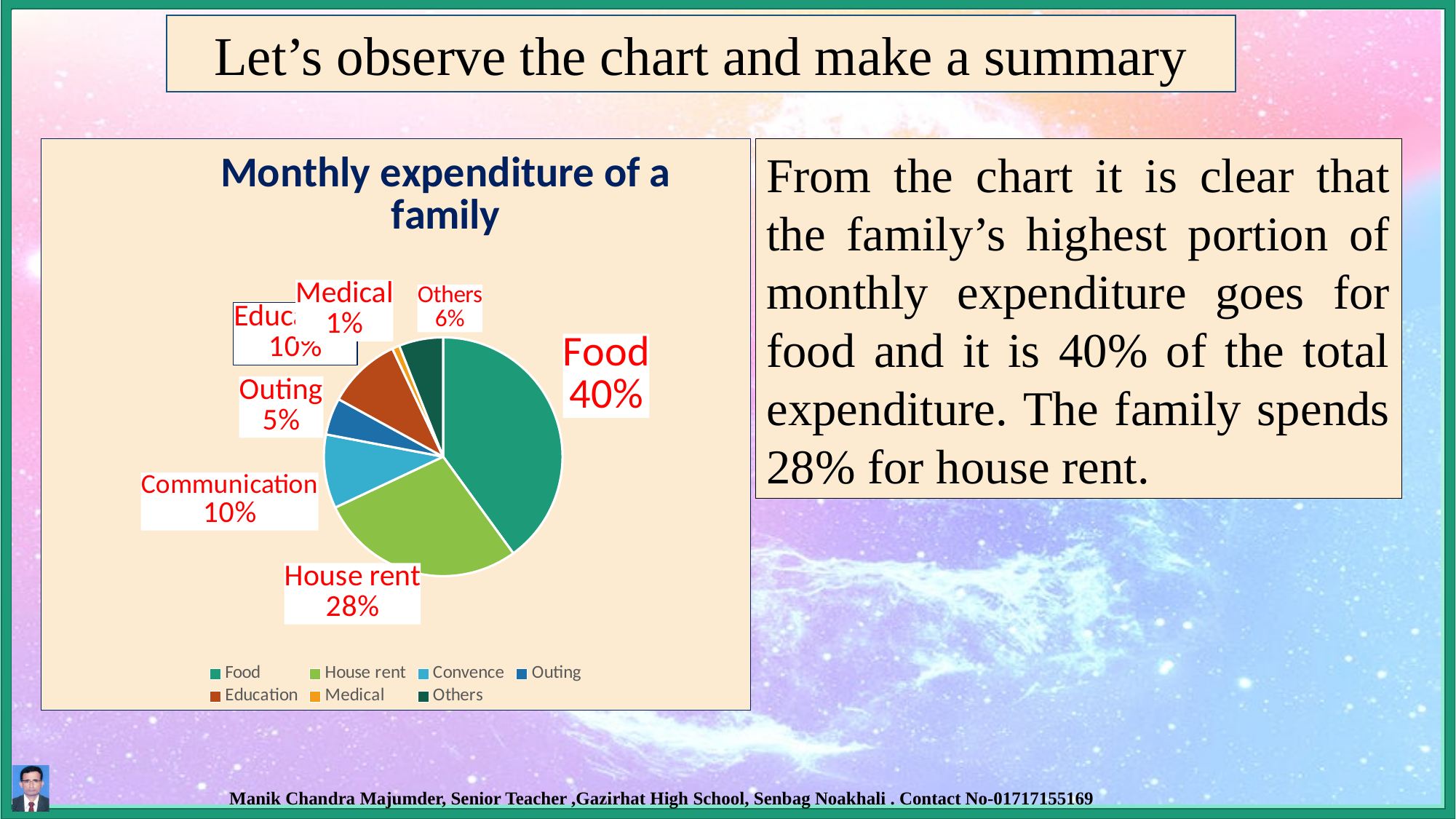
What percentage of the expenditure is spent on House rent? 28% Which is larger, the share for Others or the share for Outing? Others What is the value shown for Outing? 5% What share of the monthly expenditure goes to Food? 40% What is the value shown for Others? 6% What type of chart is shown on the slide? pie chart How many categories does the legend list? 7 Which category has the smallest share of the pie? Medical What is the title of the chart? Monthly expenditure of a family What is the value shown for Medical? 1% How many percentage points larger is Food than House rent? 12 Which category has the largest share of the pie? Food